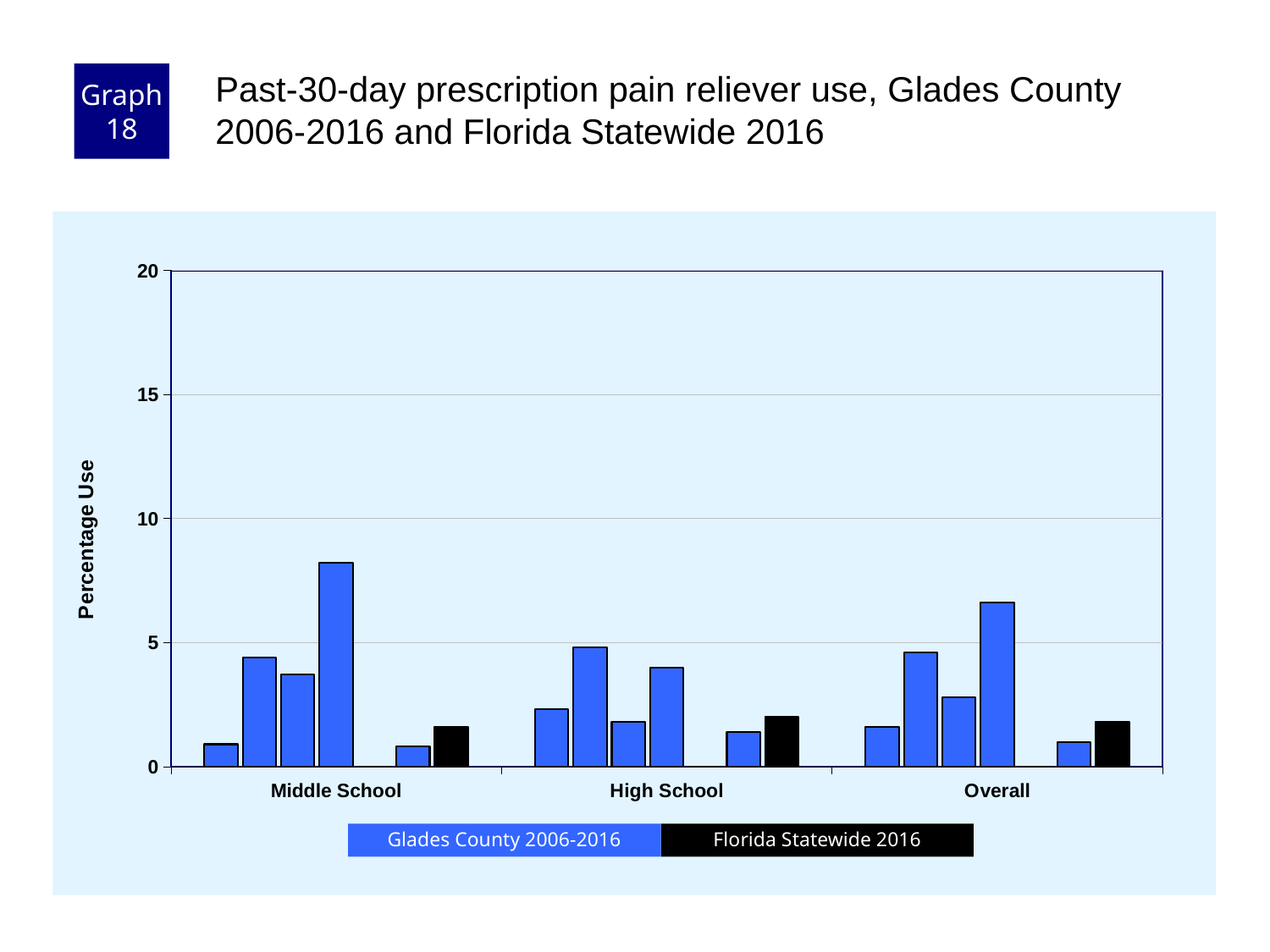
Is the tallest Glades County 2006-2016 bar in the High School group greater or less than 10? less How many series does the legend list? 2 Is the tallest Glades County 2006-2016 bar in the Middle School group greater or less than 5? greater Which series is shown in black in the legend? Florida Statewide 2016 Is the Florida Statewide 2016 value for Middle School greater or less than 5? less What kind of chart is shown on the slide? bar chart Is the Florida Statewide 2016 value larger for High School or for Middle School? High School How many school-level groups are shown on the x axis? 3 What is the title of the y axis? Percentage Use In which group does the tallest bar on the chart appear? Middle School